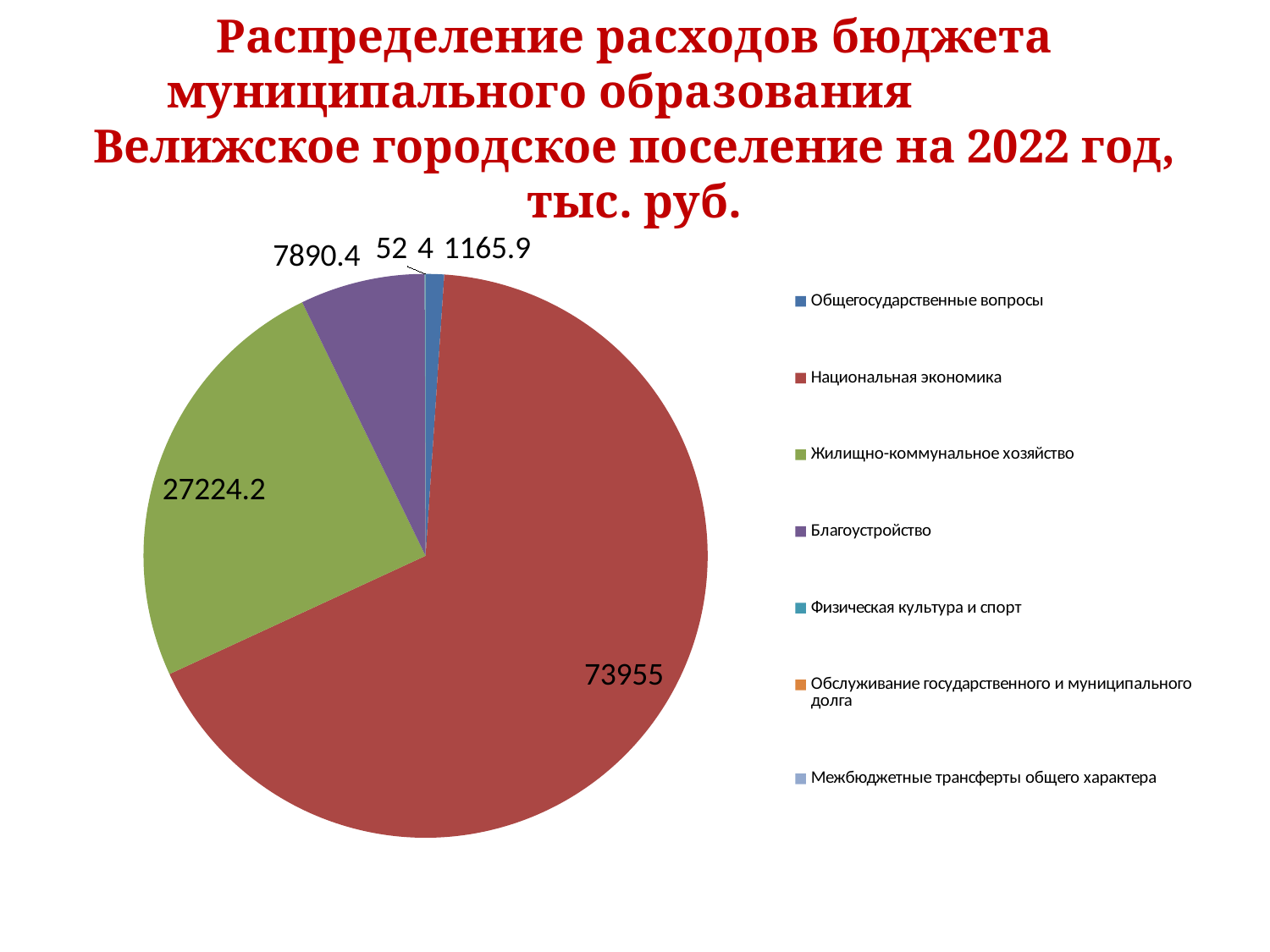
What is the value for Благоустройство? 7890.4 What is the value for Жилищно-коммунальное хозяйство? 27224.2 Which is larger, Жилищно-коммунальное хозяйство or Благоустройство? Жилищно-коммунальное хозяйство What is the difference between the values for Жилищно-коммунальное хозяйство and Благоустройство? 19333.8 How many categories does the legend of the pie chart list? 7 What kind of chart is shown on the slide? pie chart What is the difference between the values for Благоустройство and Общегосударственные вопросы? 6724.5 What colour is the slice for Национальная экономика? red Which category has the largest slice of the pie? Национальная экономика What is the value for Общегосударственные вопросы? 1165.9 What is the value for Национальная экономика? 73955 What is the difference between the values for Национальная экономика and Жилищно-коммунальное хозяйство? 46730.8